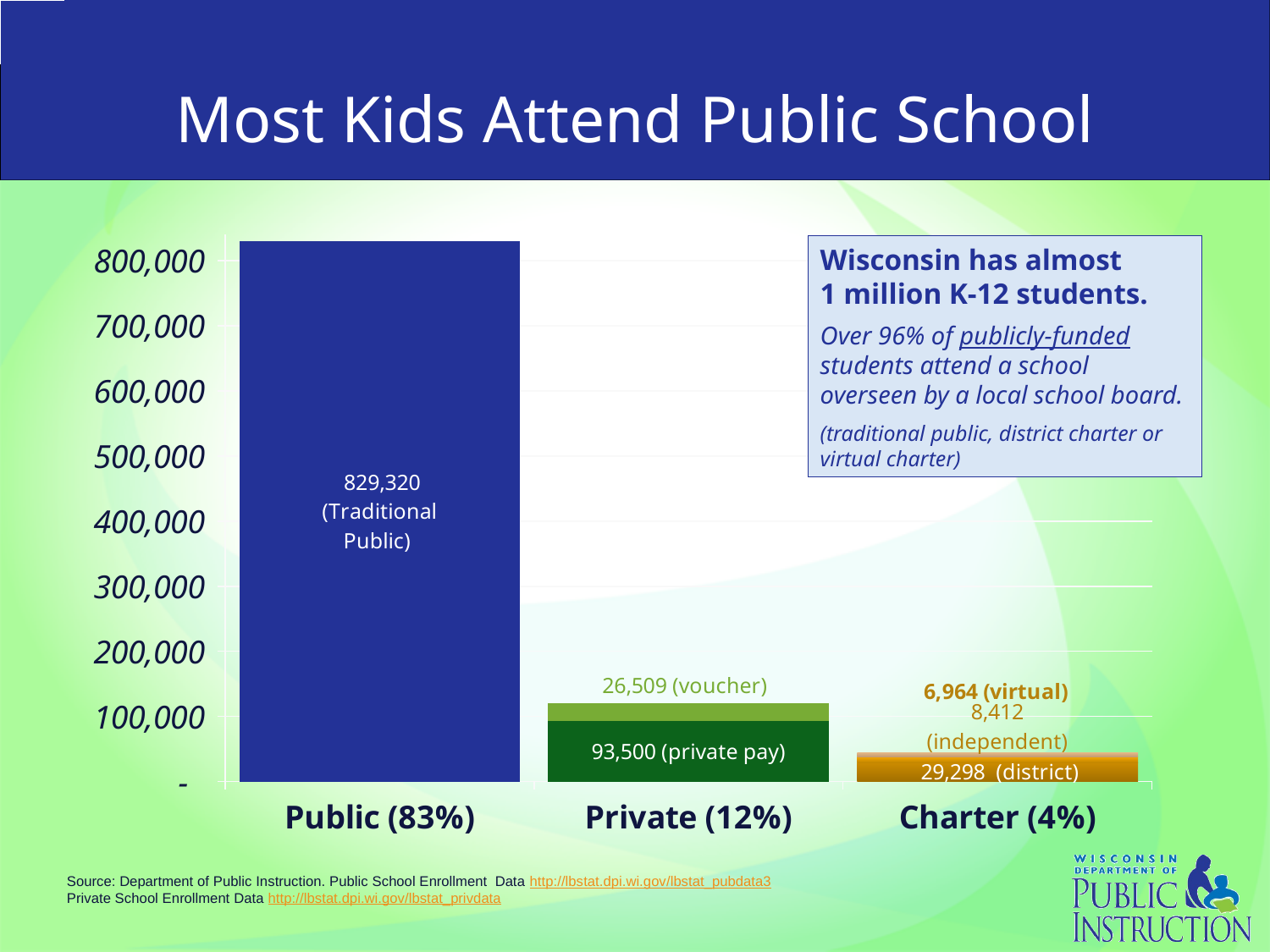
Is the district charter segment larger or smaller than the independent charter segment? larger Which category has the tallest bar? Public (83%) What is the value of the virtual segment in the Charter (4%) bar? 6,964 Which category has the shortest bar? Charter (4%) What is the total of the Charter (4%) stacked bar? 44,674 What is the value of the private pay segment in the Private (12%) bar? 93,500 What is the value of the Traditional Public segment in the Public (83%) bar? 829,320 How many categories are shown on the x axis? 3 What is the value of the voucher segment in the Private (12%) bar? 26,509 What is the difference between the private pay segment and the voucher segment in the Private (12%) bar? 66,991 What is the value of the district segment in the Charter (4%) bar? 29,298 What is the total of the Private (12%) stacked bar? 120,009